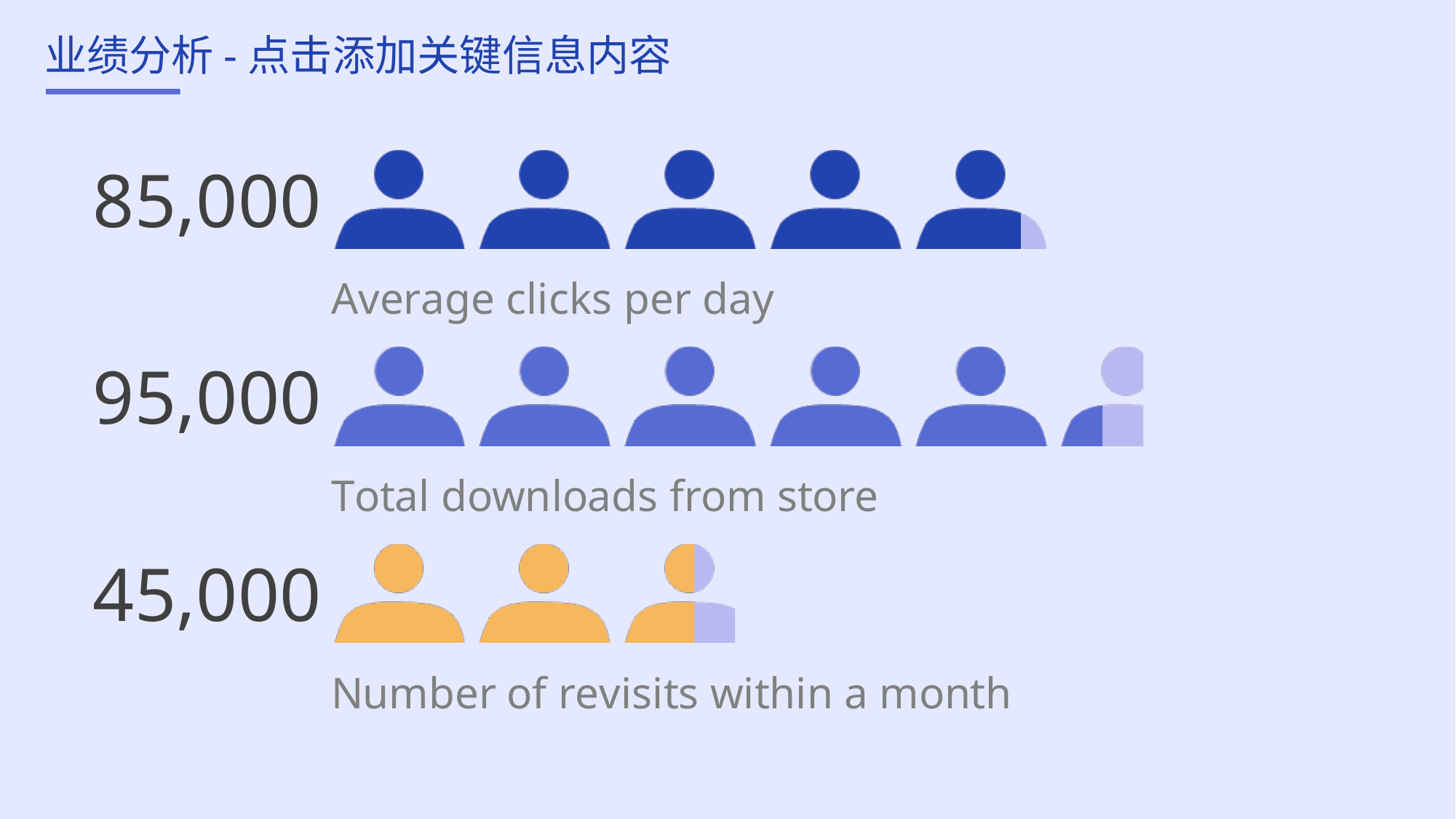
What colour are the icons for Number of revisits within a month? Orange What is the value shown for Average clicks per day? 85,000 Which metric has the lowest value? Number of revisits within a month Which is larger, Average clicks per day or Number of revisits within a month? Average clicks per day Which metric has the highest value? Total downloads from store What is the value shown for Number of revisits within a month? 45,000 What is the value shown for Total downloads from store? 95,000 What kind of chart is used to show the values? Pictogram (icon) chart What is the difference between Total downloads from store and Average clicks per day? 10,000 What is the difference between Average clicks per day and Number of revisits within a month? 40,000 Which metric is represented by the dark blue icons? Average clicks per day How many metrics are shown on the slide? 3